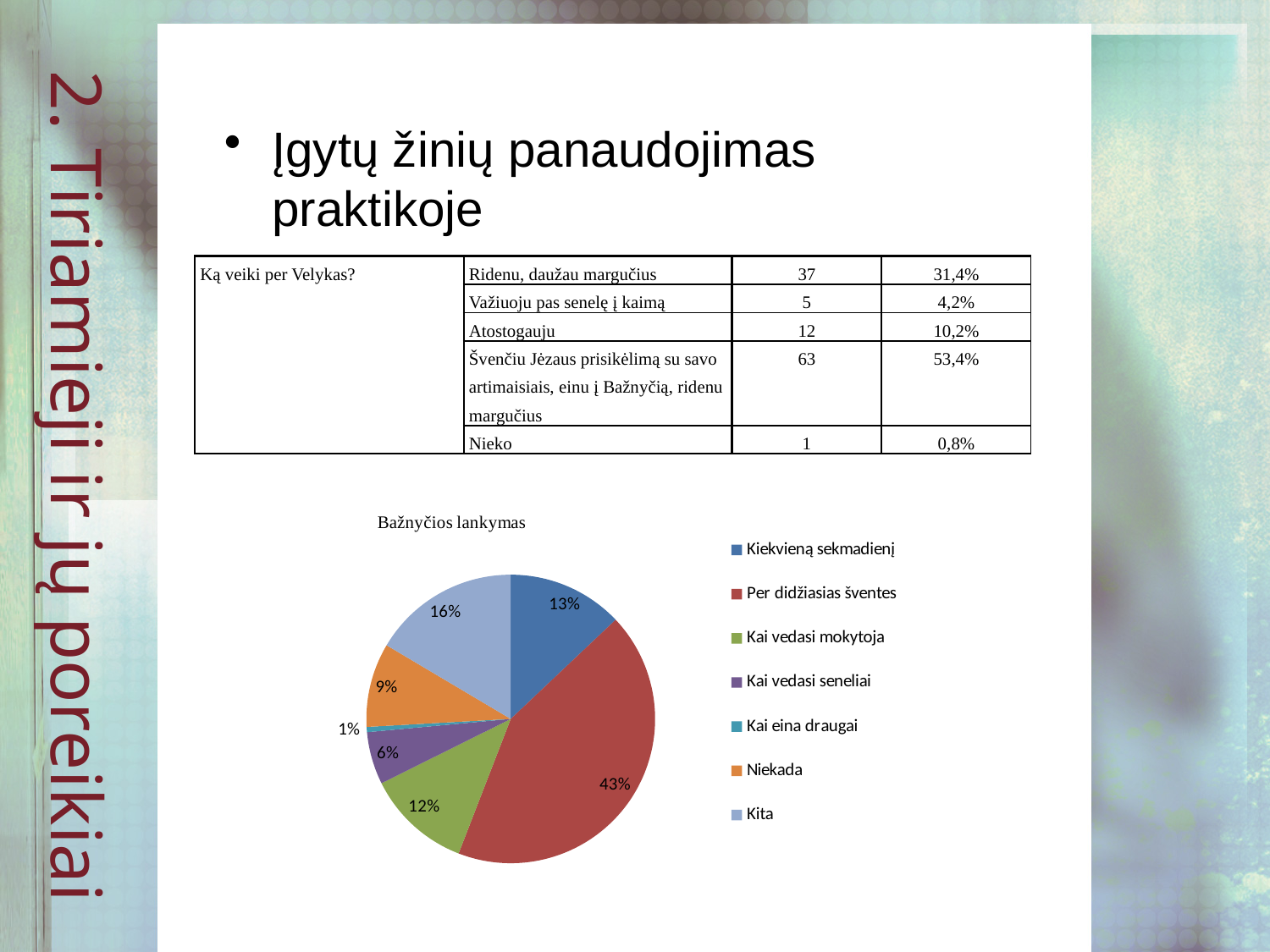
What is the difference in percentage points between "Per didžiasias šventes" and "Kita"? 27 How many slices does the pie chart have? 7 What share of the pie is "Kiekvieną sekmadienį"? 13% Which is larger, the slice for "Kai vedasi mokytoja" or the slice for "Kai vedasi seneliai"? Kai vedasi mokytoja Which category has the largest slice of the pie? Per didžiasias šventes What share of the pie is "Niekada"? 9% What type of chart is shown on the slide? pie chart Which category has the smallest slice of the pie? Kai eina draugai What colour is the slice for "Niekada"? orange What share of the pie is "Kita"? 16% What is the title of the chart? Bažnyčios lankymas